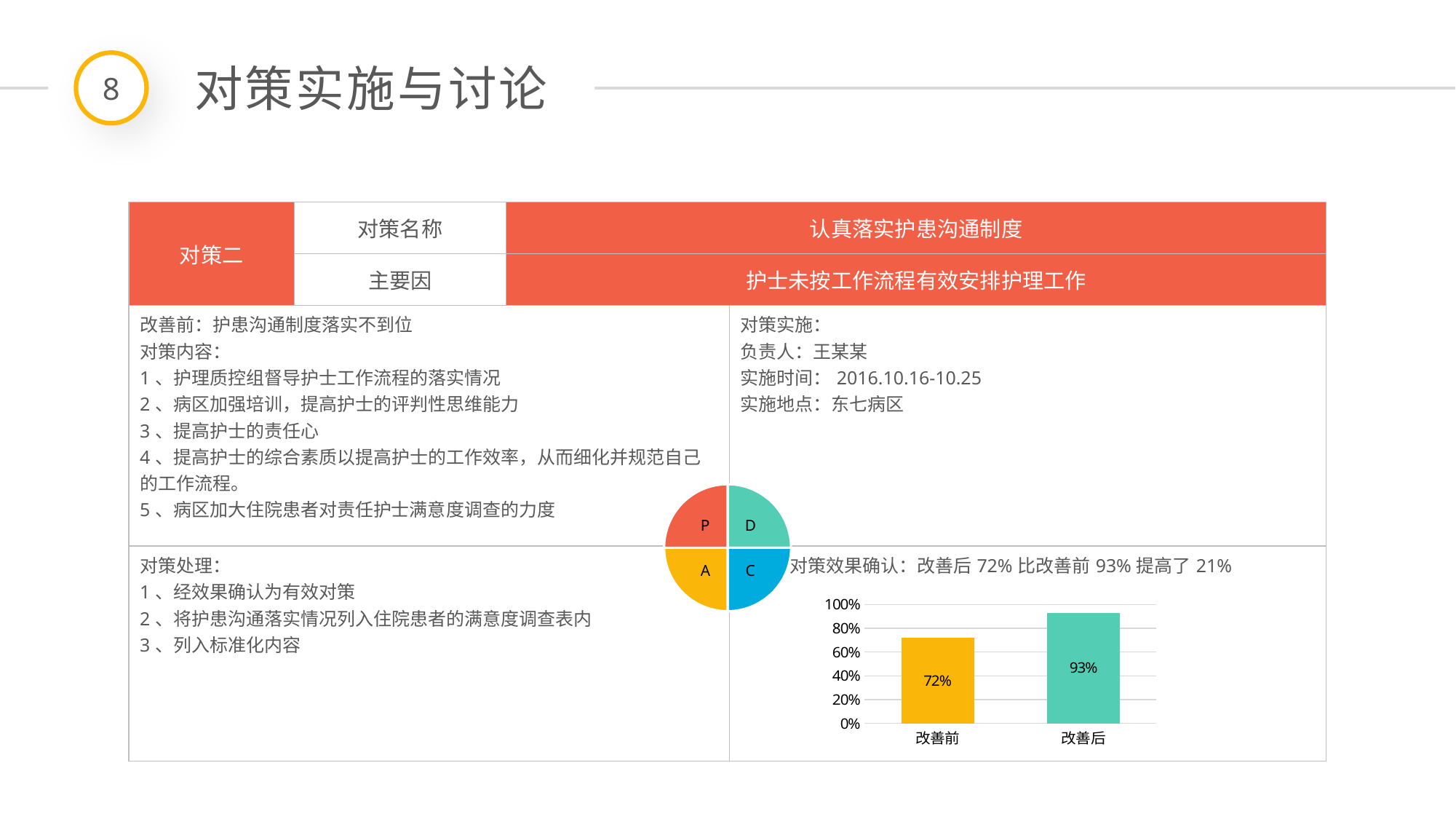
Which is larger in the bar chart, 改善前 or 改善后? 改善后 Do the values rise or fall from 改善前 to 改善后 in the bar chart? rise What is the maximum value shown on the y axis of the bar chart? 100% How many categories are shown in the bar chart? 2 What kind of chart is shown at the bottom right of the slide? bar chart Which category has the highest value in the bar chart? 改善后 Is the value for 改善前 greater or less than 80%? less What is the difference between the values for 改善后 and 改善前 in the bar chart? 21% Is the value for 改善后 greater or less than 80%? greater What is the value for 改善前 in the bar chart? 72% What is the value for 改善后 in the bar chart? 93% Which category has the lowest value in the bar chart? 改善前